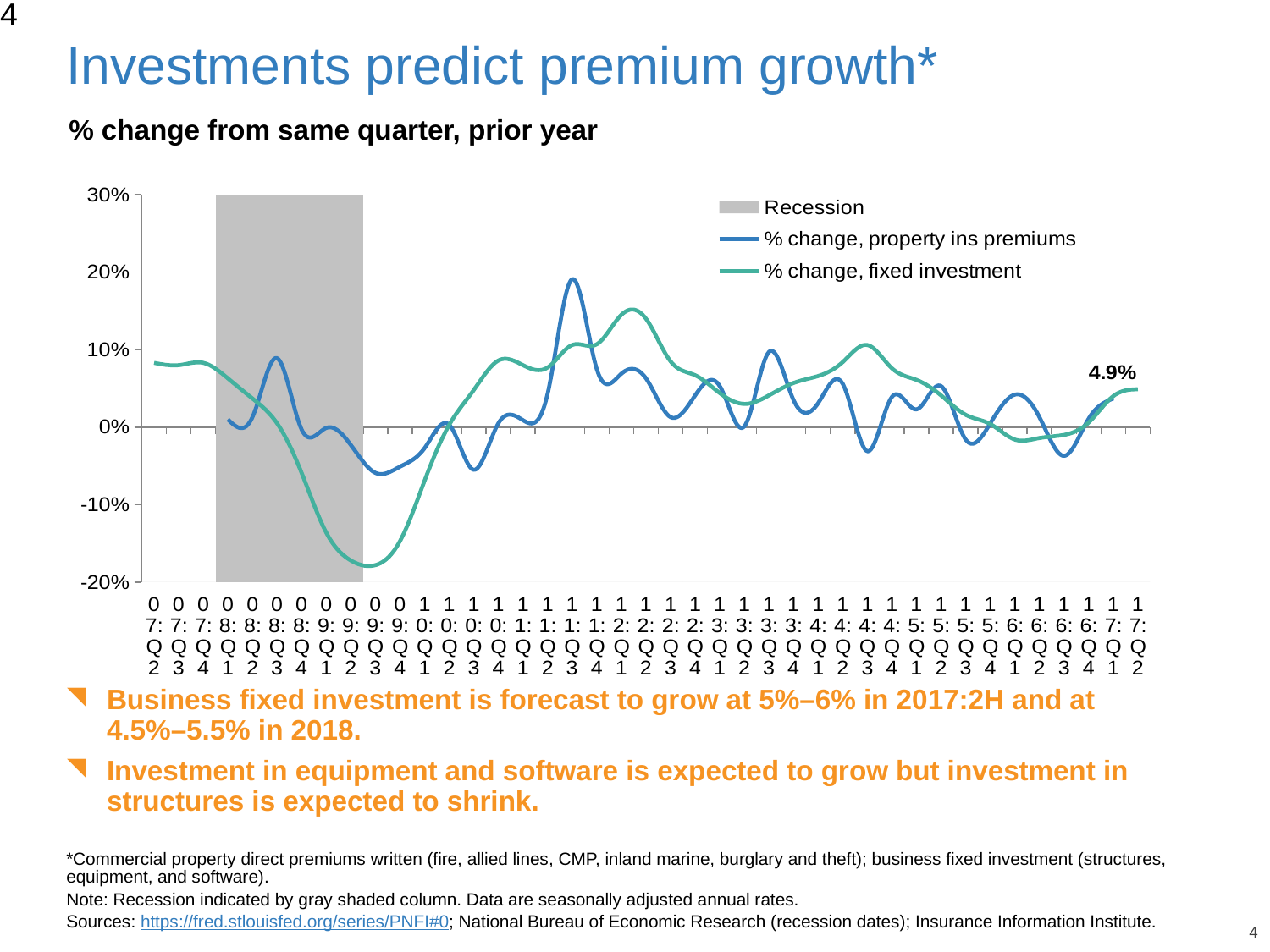
What kind of chart is shown on the slide? line chart Which series reaches the highest peak on the chart, property ins premiums or fixed investment? % change, property ins premiums Is the lowest value of the fixed investment line during the recession greater or less than -10%? less Is the peak of the property ins premiums line around 11:Q4 greater or less than 10%? greater At 09:Q2, which series has the higher value, property ins premiums or fixed investment? % change, property ins premiums What value is printed as a data label at the right end of the fixed investment line? 4.9% Which series reaches the lowest value on the chart, property ins premiums or fixed investment? % change, fixed investment How many quarters are labeled on the x axis? 41 What does the gray shaded column on the chart indicate? Recession How many entries does the chart legend list? 3 Does the fixed investment line rise or fall from 08:Q1 to 09:Q2? fall At 11:Q4, which series has the higher value, property ins premiums or fixed investment? % change, fixed investment